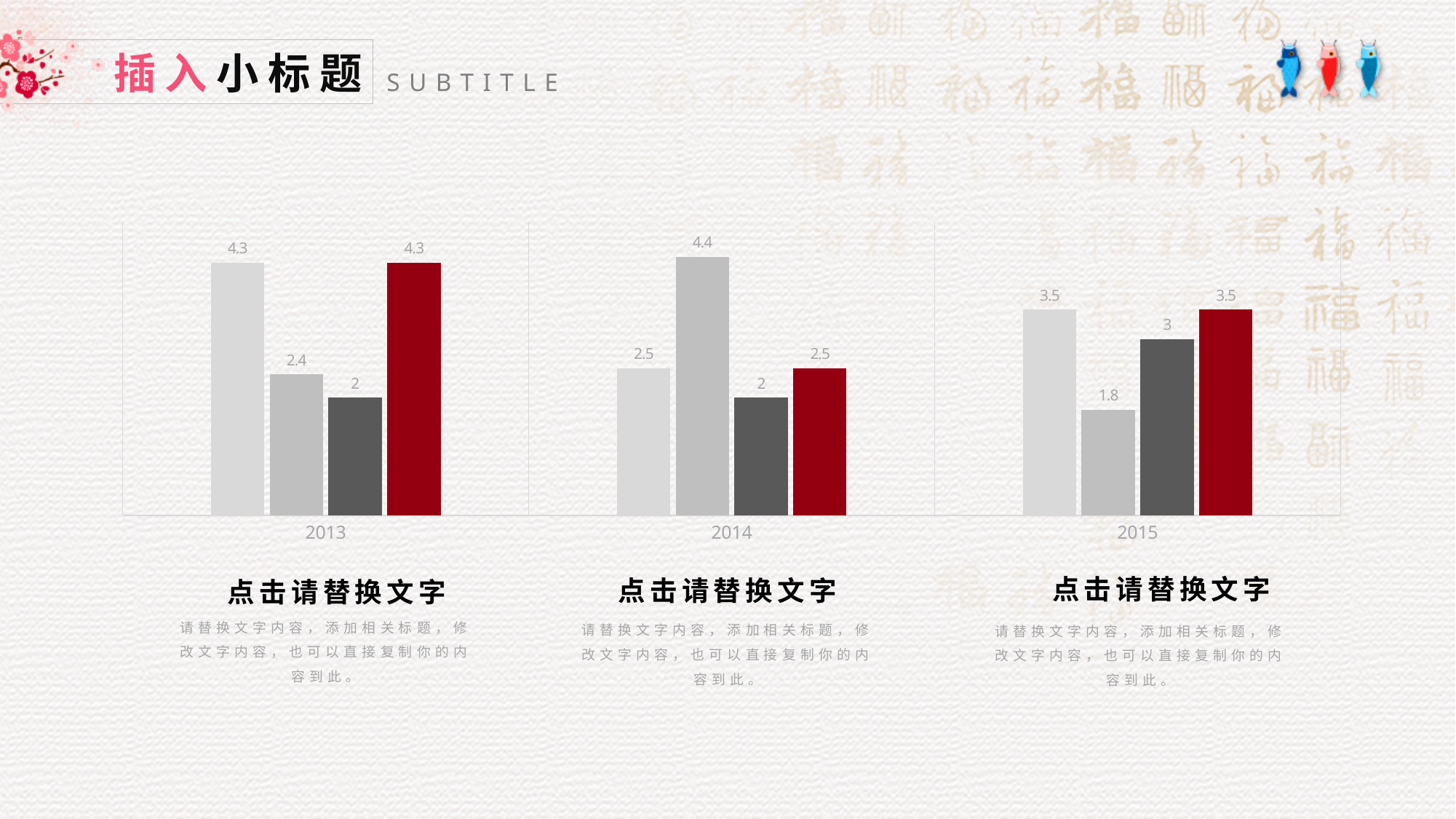
How many bars are shown in the middle chart labelled 2014? 4 What year label appears under the right chart? 2015 In the middle chart labelled 2014, what is the value of the red bar? 2.5 In the left chart labelled 2013, what is the difference between the first bar (4.3) and the second bar (2.4)? 1.9 In the right chart labelled 2015, which is larger: the dark gray bar or the second light gray bar? the dark gray bar In the middle chart labelled 2014, what is the value of the tallest bar? 4.4 In the right chart labelled 2015, what is the value of the dark gray bar? 3 In the left chart labelled 2013, what is the value of the red bar? 4.3 What kind of chart is the left chart labelled 2013? bar chart In the left chart labelled 2013, what is the value of the dark gray bar? 2 In the right chart labelled 2015, what is the value of the lowest bar? 1.8 In the middle chart labelled 2014, what is the difference between the tallest bar (4.4) and the dark gray bar (2)? 2.4